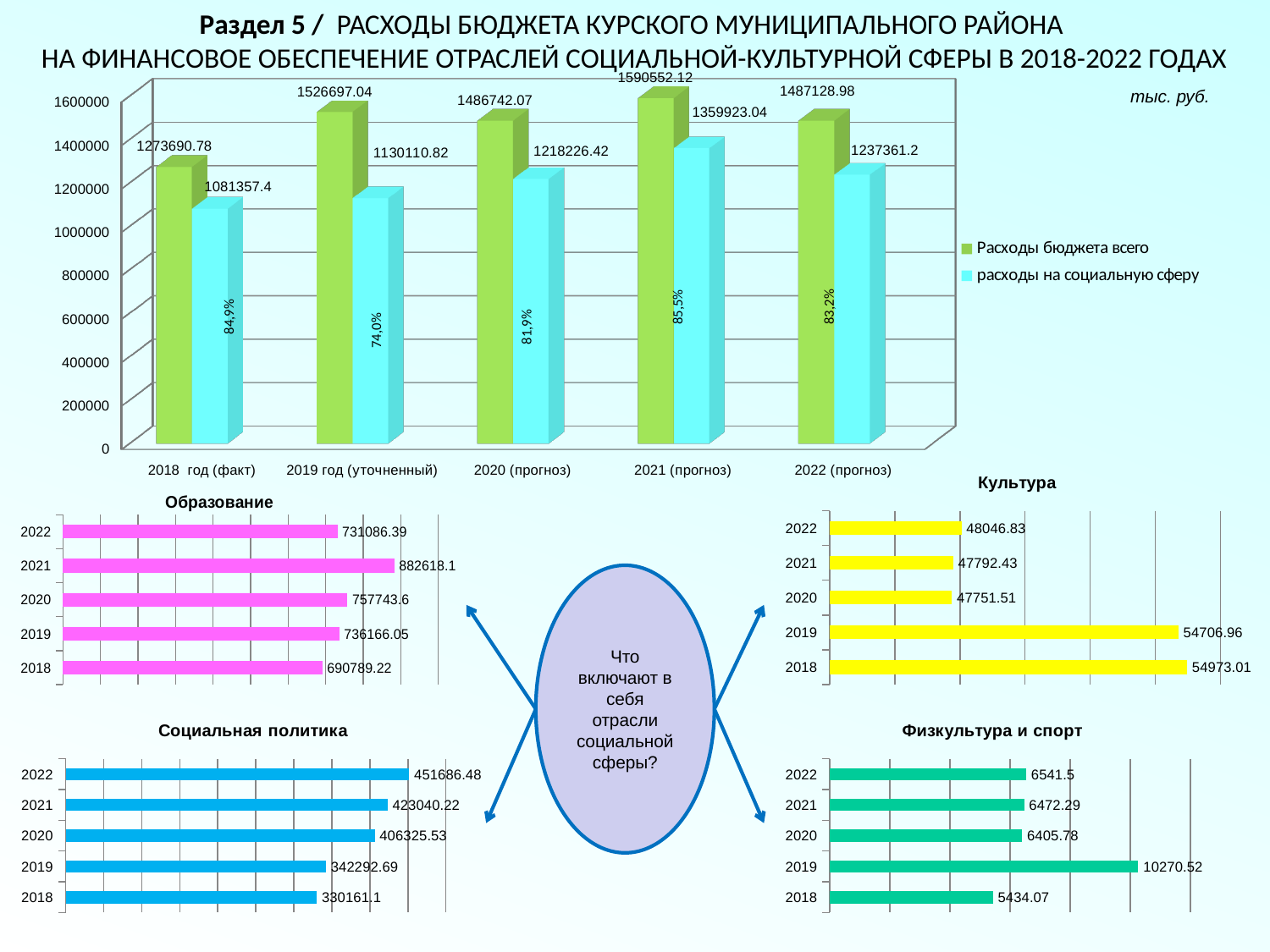
In the 'Физкультура и спорт' chart, which is larger: the value for 2019 or the value for 2022? 2019 In the 'Социальная политика' chart, do the values rise or fall from 2018 to 2022? rise How many series does the legend of the top chart list? 2 In the top chart, which year has the highest value for 'Расходы бюджета всего'? 2021 (прогноз) How many year categories are shown in the top chart? 5 What kind of chart is the 'Социальная политика' chart? bar chart In the 'Образование' chart, what is the value for 2021? 882618.1 In the 'Образование' chart, which year has the lowest value? 2018 In the 'Культура' chart, which year has the highest value? 2018 In the top chart, what is the value of 'расходы на социальную сферу' for 2018 год (факт)? 1081357.4 In the top chart, what is the difference between 'Расходы бюджета всего' and 'расходы на социальную сферу' for 2021 (прогноз)? 230629.08 In the top chart, what is the value of 'Расходы бюджета всего' for 2021 (прогноз)? 1590552.12